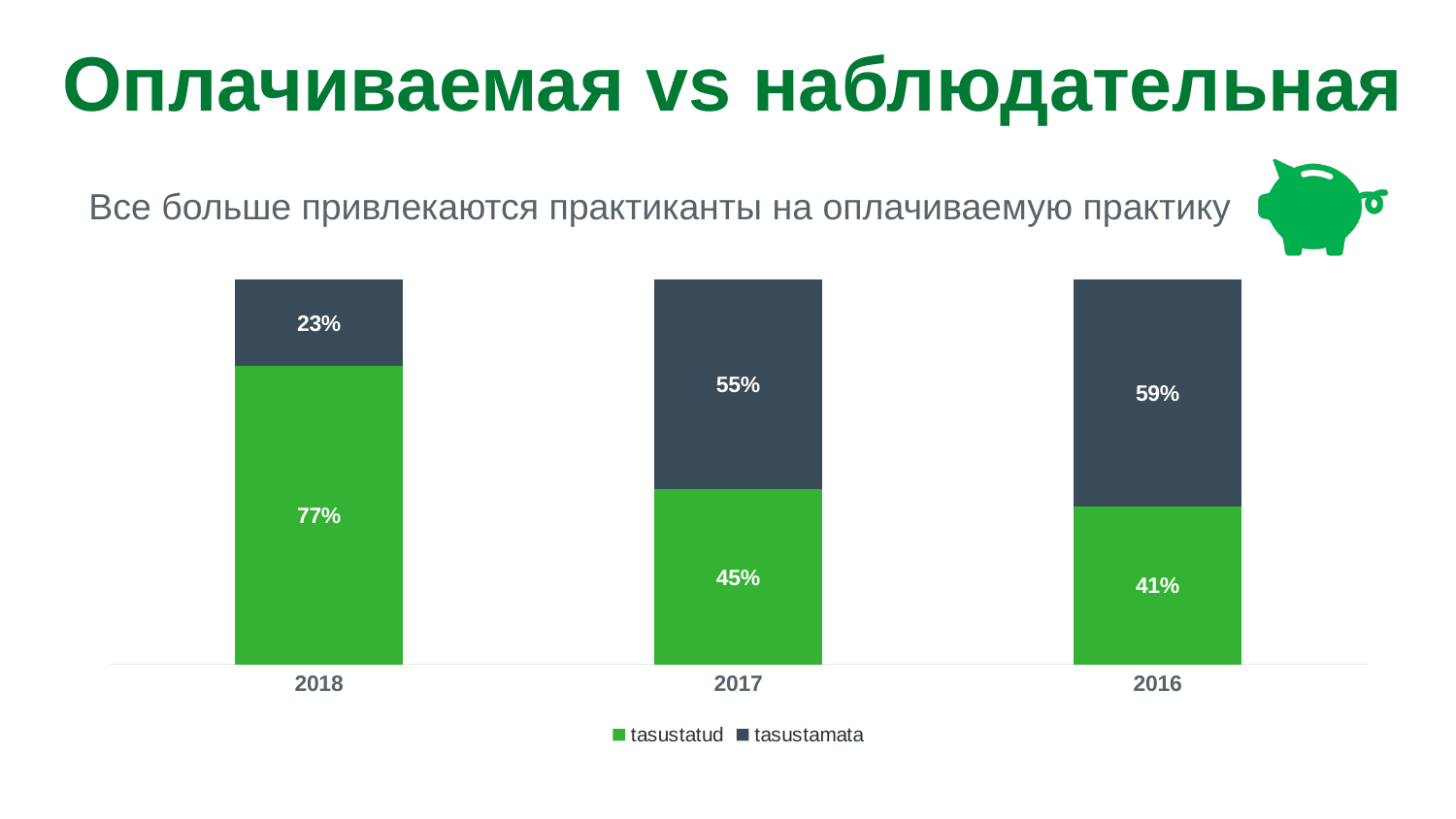
What is the total of the stacked bar for 2016? 100% What kind of chart is shown on the slide? Stacked bar chart What is the value for tasustatud in 2018? 77% How many series does the legend list? 2 How many years are shown on the x axis? 3 What is the difference between the tasustatud values for 2018 and 2017? 32% What is the value for tasustamata in 2017? 55% What is the value for tasustatud in 2016? 41% What is the value for tasustamata in 2018? 23% Which year has the highest value for tasustatud? 2018 Which is larger: tasustatud in 2017 or tasustamata in 2017? tasustamata Which year has the lowest value for tasustamata? 2018